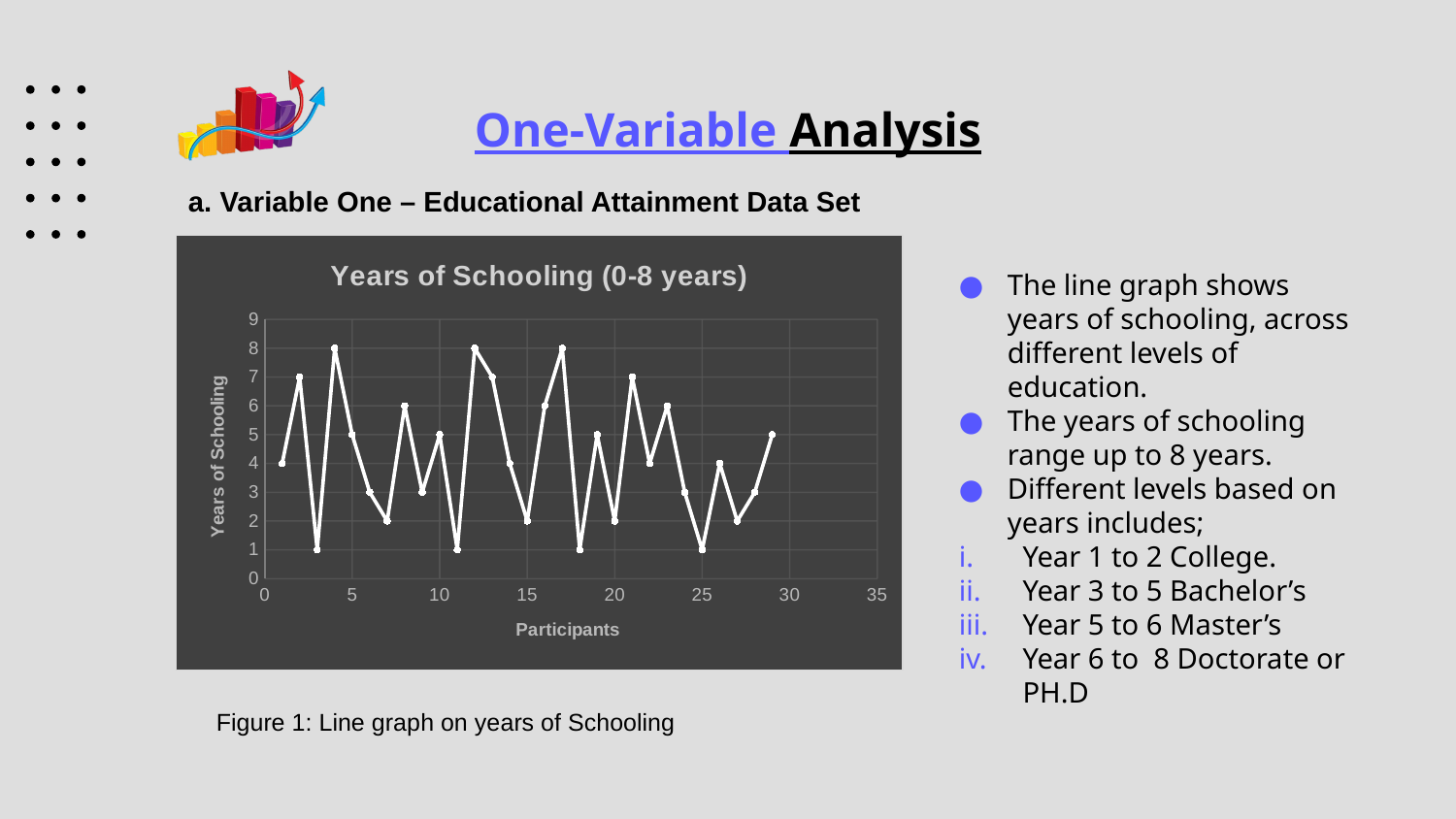
What is the years of schooling value for participant 1, the first point on the chart? 4 What is the years of schooling value for the last point on the chart, participant 29? 5 What is the difference between the years of schooling values for participant 4 and participant 3? 7 What is the years of schooling value for participant 4? 8 Is the value for participant 25 greater or less than 5? less What is the title of the chart? Years of Schooling (0-8 years) What is the years of schooling value for participant 25? 1 What kind of chart is shown on the slide? line chart What is the highest value of years of schooling reached on the chart? 8 What is the label on the x axis of the chart? Participants Which has the higher years of schooling value, participant 2 or participant 3? participant 2 What is the lowest value of years of schooling reached on the chart? 1